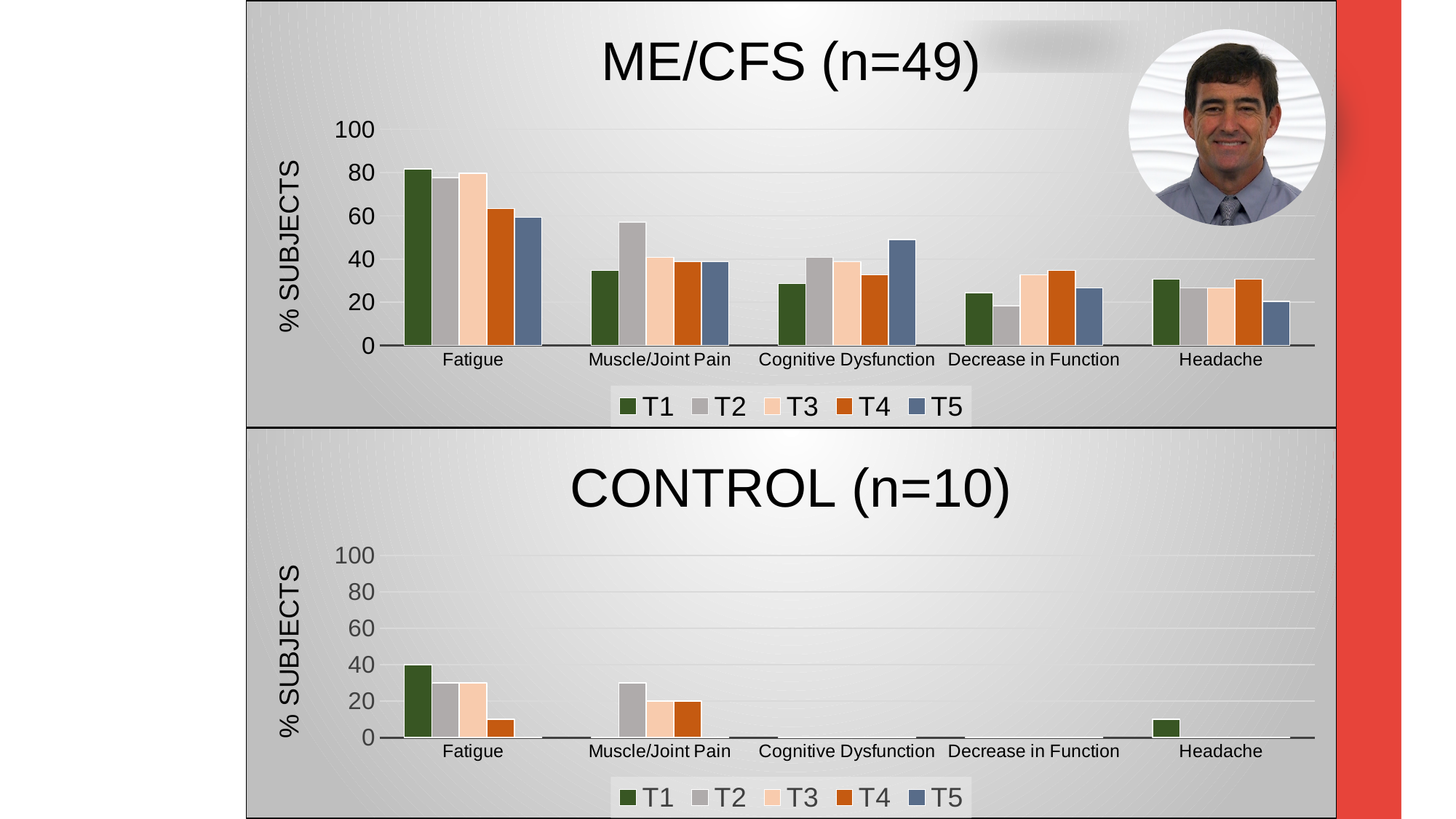
How many symptom categories are shown on the x axis of the ME/CFS (n=49) chart? 5 What type of chart is the ME/CFS (n=49) chart? bar chart In the CONTROL (n=10) chart, what is the T1 value for Fatigue? 40 In the CONTROL (n=10) chart, what is the T3 value for Muscle/Joint Pain? 20 What is the y-axis label of the CONTROL (n=10) chart? % SUBJECTS In the ME/CFS (n=49) chart, which category has the highest T1 value? Fatigue In the ME/CFS (n=49) chart, is the T1 value for Fatigue greater or less than 80? greater In the ME/CFS (n=49) chart, which is larger for Cognitive Dysfunction: T1 or T5? T5 In the CONTROL (n=10) chart, is the T4 value for Fatigue greater or less than 20? less In the ME/CFS (n=49) chart, do the Fatigue values rise or fall from T3 to T5? fall In the ME/CFS (n=49) chart, is the T5 value for Headache greater or less than 40? less How many series does the legend of the CONTROL (n=10) chart list? 5